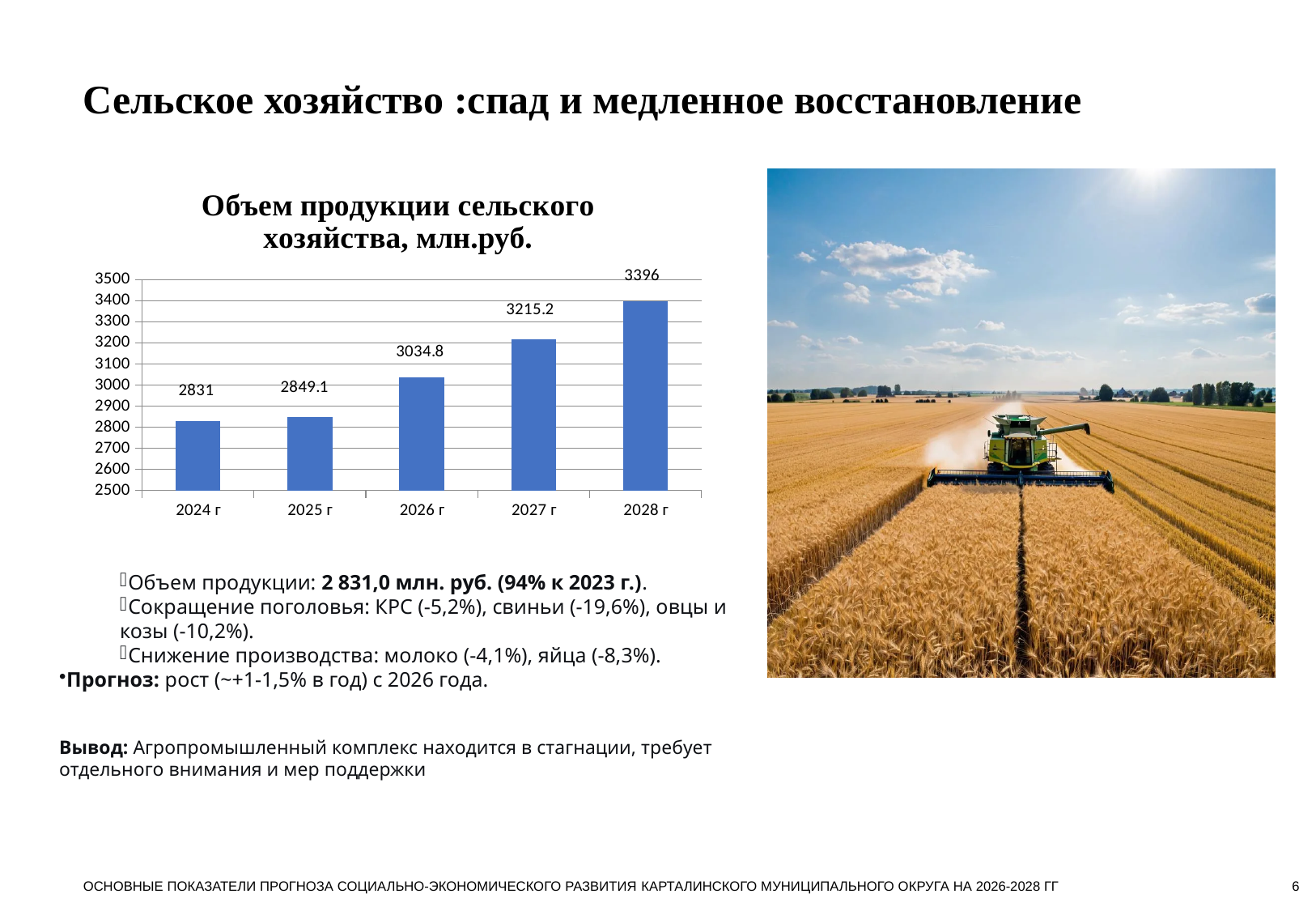
How many years are shown on the x axis of the chart? 5 What is the value for 2026 г in the chart? 3034.8 Is the value for 2026 г greater or less than 3000? greater What kind of chart is shown on the slide? bar chart What is the difference between the values for 2028 г and 2027 г? 180.8 Which year has the highest value in the chart? 2028 г What is the value for 2028 г in the chart? 3396 Which is larger, the value for 2027 г or the value for 2026 г? 2027 г Which year has the lowest value in the chart? 2024 г Do the values rise or fall from 2024 г to 2028 г? rise What is the difference between the values for 2025 г and 2024 г? 18.1 What is the value for 2024 г in the chart? 2831